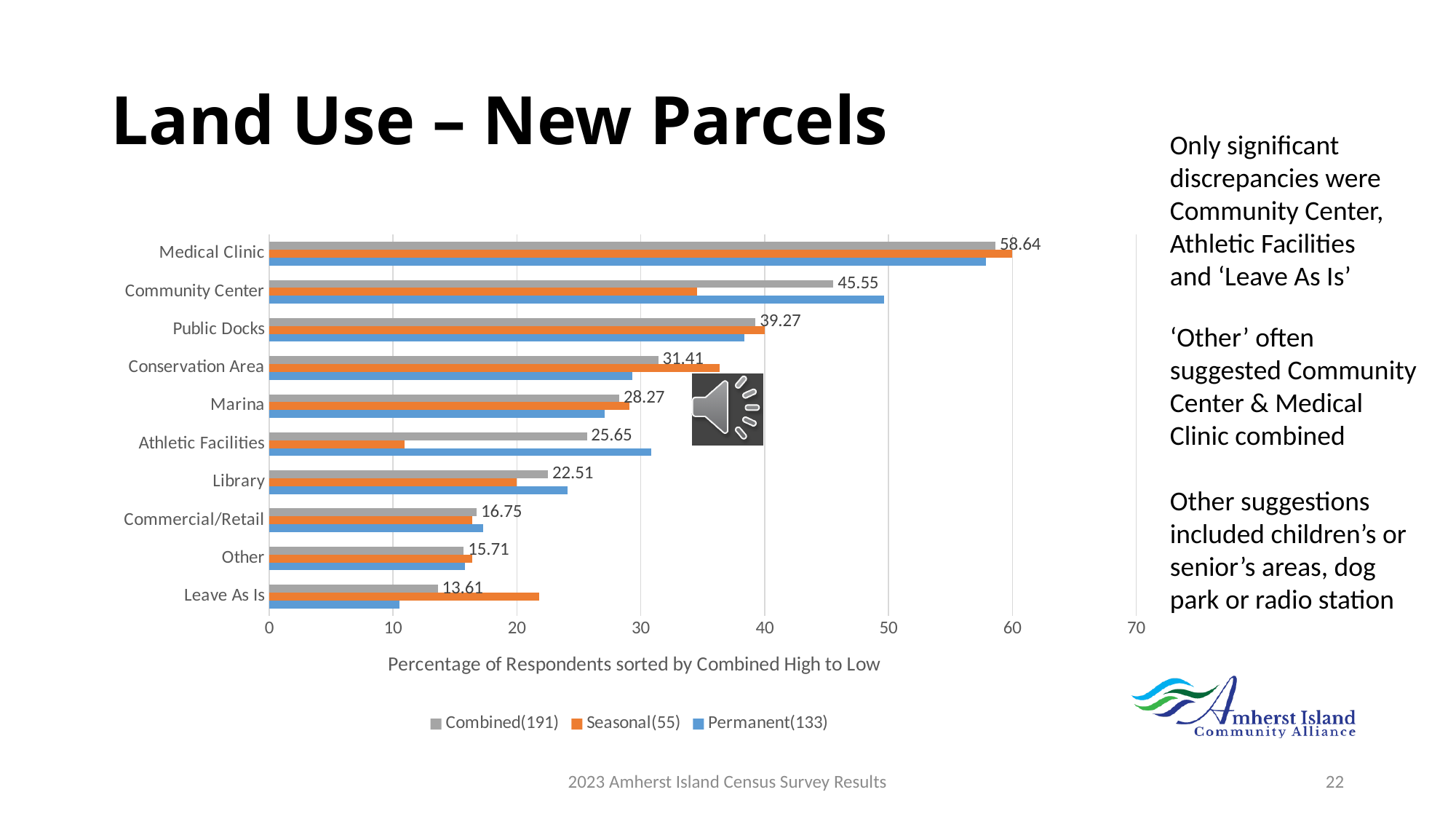
What is the Combined(191) value for Medical Clinic? 58.64 What kind of chart is shown on the slide? Bar chart Is the Permanent(133) value for Community Center greater or less than 40? greater Which category has the lowest Combined(191) value? Leave As Is How many series does the legend list? 3 What is the difference between the Combined(191) values for Medical Clinic and Community Center? 13.09 Is the Seasonal(55) value for Athletic Facilities greater or less than 20? less What is the Combined(191) value for Community Center? 45.55 How many categories are shown on the chart? 10 Which category has the highest Combined(191) value? Medical Clinic Which has the larger Combined(191) value, Marina or Athletic Facilities? Marina What is the Combined(191) value for Library? 22.51